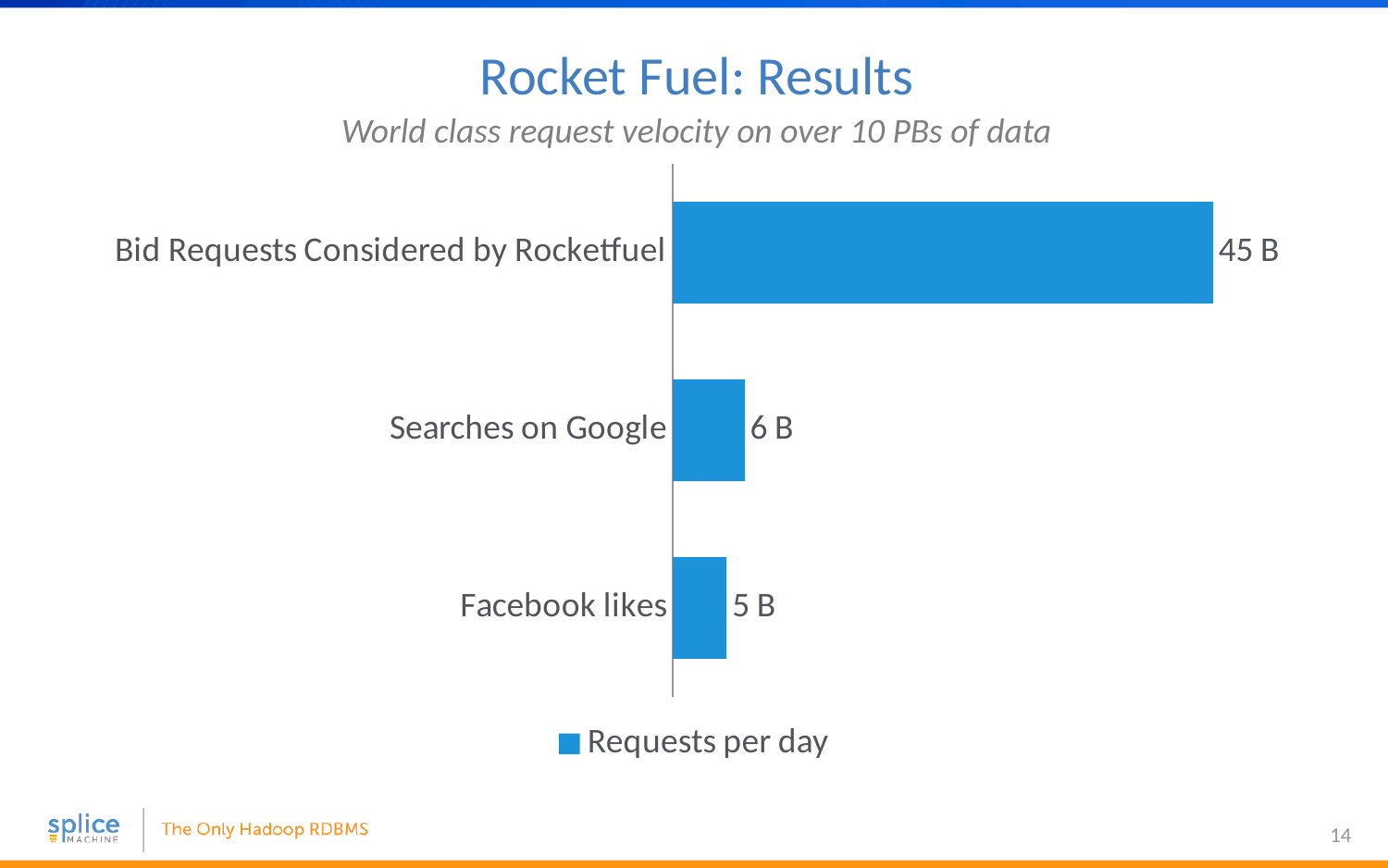
What kind of chart is shown on the slide? Bar chart How many categories are shown in the chart? 3 What is the difference between the values for Bid Requests Considered by Rocketfuel and Searches on Google? 39 B Which category has the highest value? Bid Requests Considered by Rocketfuel What is the difference between the values for Searches on Google and Facebook likes? 1 B What is the name of the series shown in the legend? Requests per day Which is larger, the value for Searches on Google or the value for Facebook likes? Searches on Google What is the value for Bid Requests Considered by Rocketfuel? 45 B What is the value for Searches on Google? 6 B How many series does the legend list? 1 What is the value for Facebook likes? 5 B Which category has the lowest value? Facebook likes